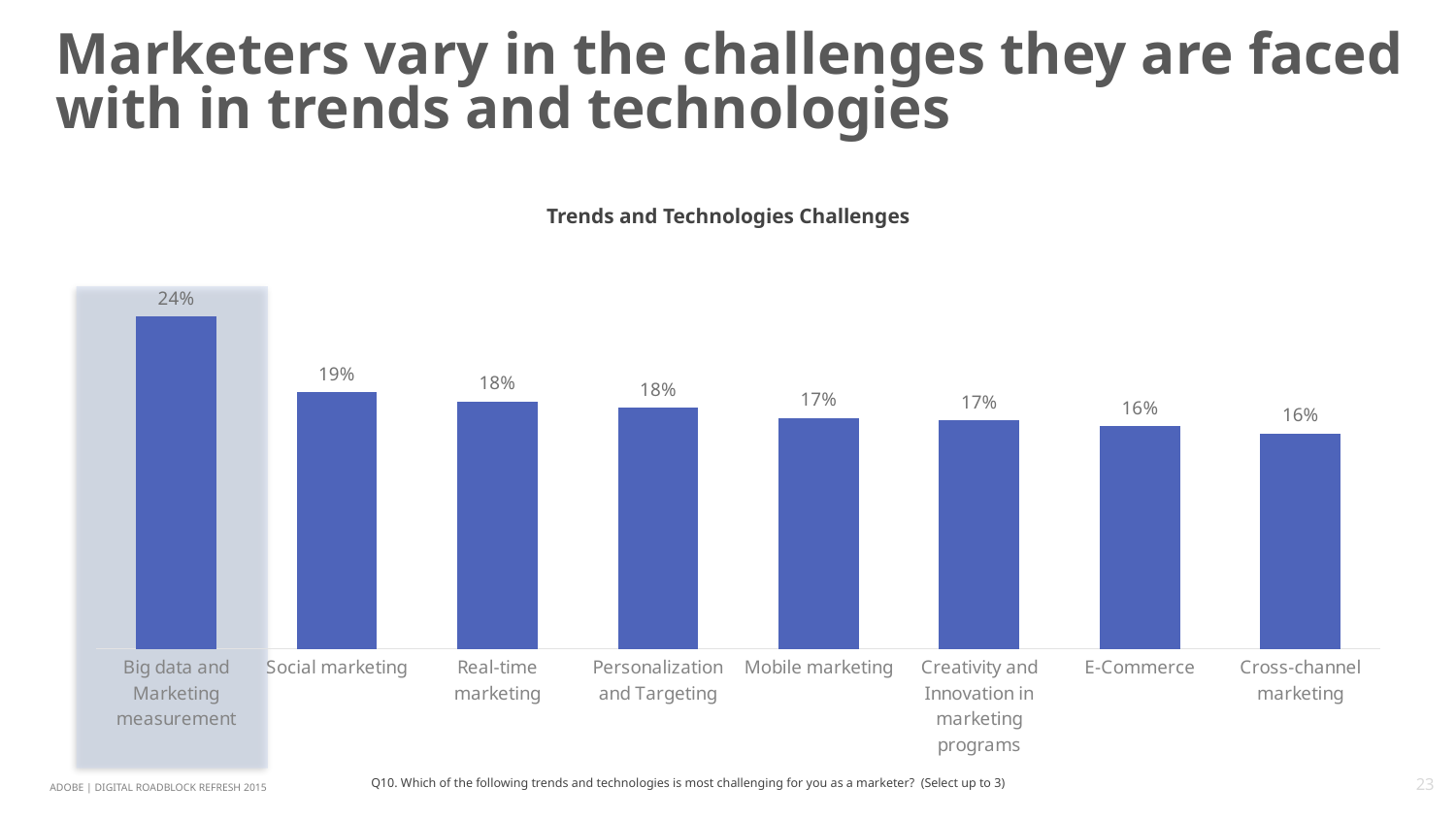
What is the value for Mobile marketing? 17% What is the title of the chart? Trends and Technologies Challenges What is the value for Big data and Marketing measurement? 24% What is the difference between the values for Real-time marketing and E-Commerce? 2% Do the values rise or fall from left to right along the x axis? Fall What kind of chart is shown on the slide? Bar chart What is the difference between the values for Big data and Marketing measurement and Social marketing? 5% Which is larger, the value for Social marketing or the value for Mobile marketing? Social marketing Which category has the highest value? Big data and Marketing measurement What is the value for Cross-channel marketing? 16% How many categories are shown in the chart? 8 What is the value for Social marketing? 19%